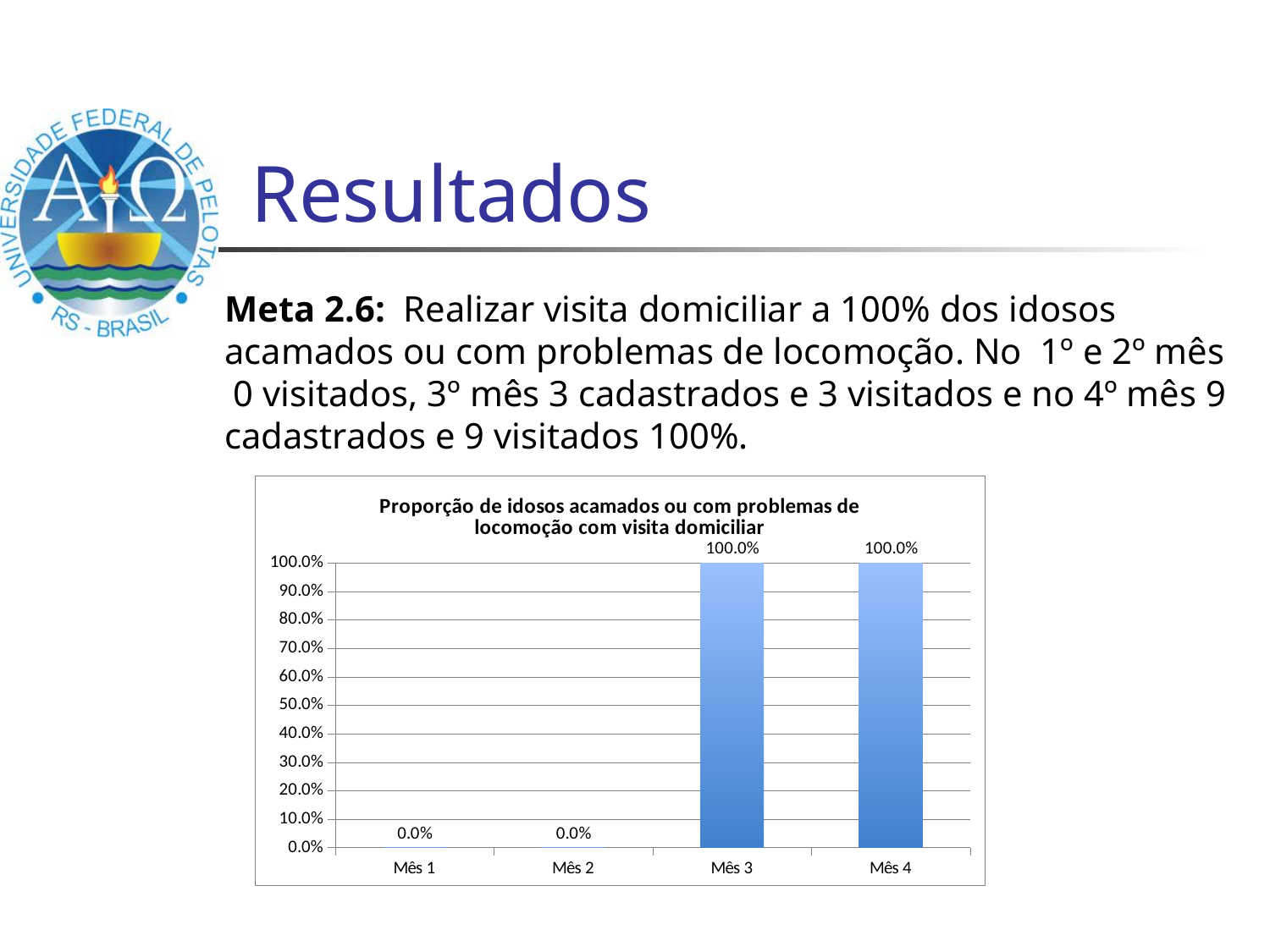
What is the difference between the values for Mês 3 and Mês 2? 100.0% How many categories are shown on the x axis? 4 What kind of chart is shown on the slide? bar chart What is the value for Mês 4? 100.0% What is the value for Mês 1? 0.0% What is the highest value shown on the y axis? 100.0% What is the value for Mês 2? 0.0% Which is larger, the value for Mês 4 or the value for Mês 1? Mês 4 Is the value for Mês 3 greater or less than 50.0%? greater What is the title of the chart? Proporção de idosos acamados ou com problemas de locomoção com visita domiciliar Do the values rise or fall from Mês 1 to Mês 4? rise What is the value for Mês 3? 100.0%